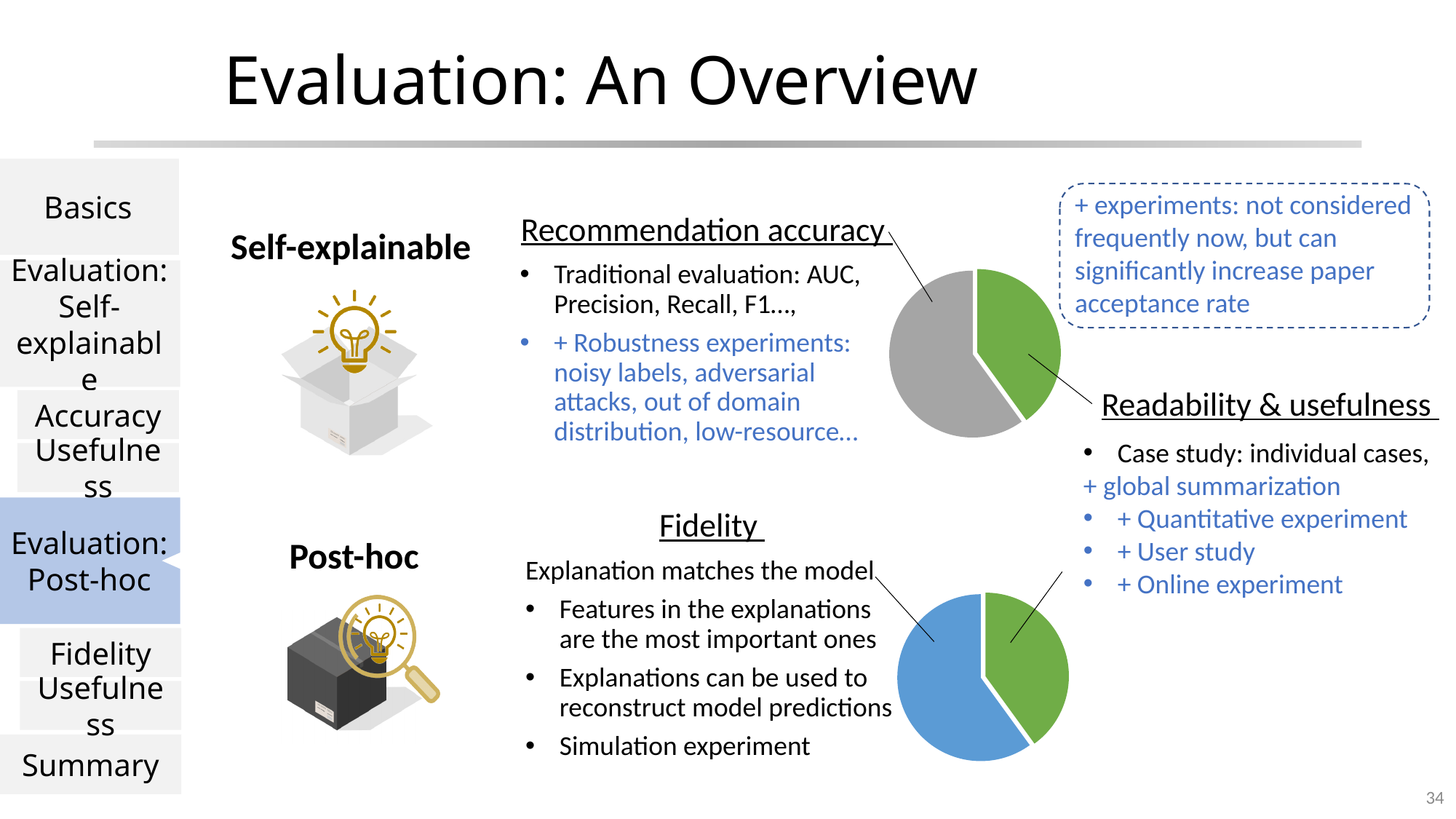
In the lower pie chart (Post-hoc), which slice is larger: the one for Fidelity or the one for Readability & usefulness? Fidelity How many slices does the lower pie chart (Post-hoc) have? 2 In the upper pie chart (Self-explainable), which slice is larger: the one for Recommendation accuracy or the one for Readability & usefulness? Recommendation accuracy In the lower pie chart (Post-hoc), what colour is the slice labelled Fidelity? Blue In the upper pie chart (Self-explainable), what colour is the slice labelled Recommendation accuracy? Gray What kind of chart is the lower chart on the slide, next to 'Post-hoc'? Pie chart How many slices does the upper pie chart (Self-explainable) have? 2 In the upper pie chart (Self-explainable), which slice is the largest? Recommendation accuracy In the lower pie chart (Post-hoc), which slice is the smallest? Readability & usefulness What kind of chart is the upper chart on the slide, next to 'Self-explainable'? Pie chart